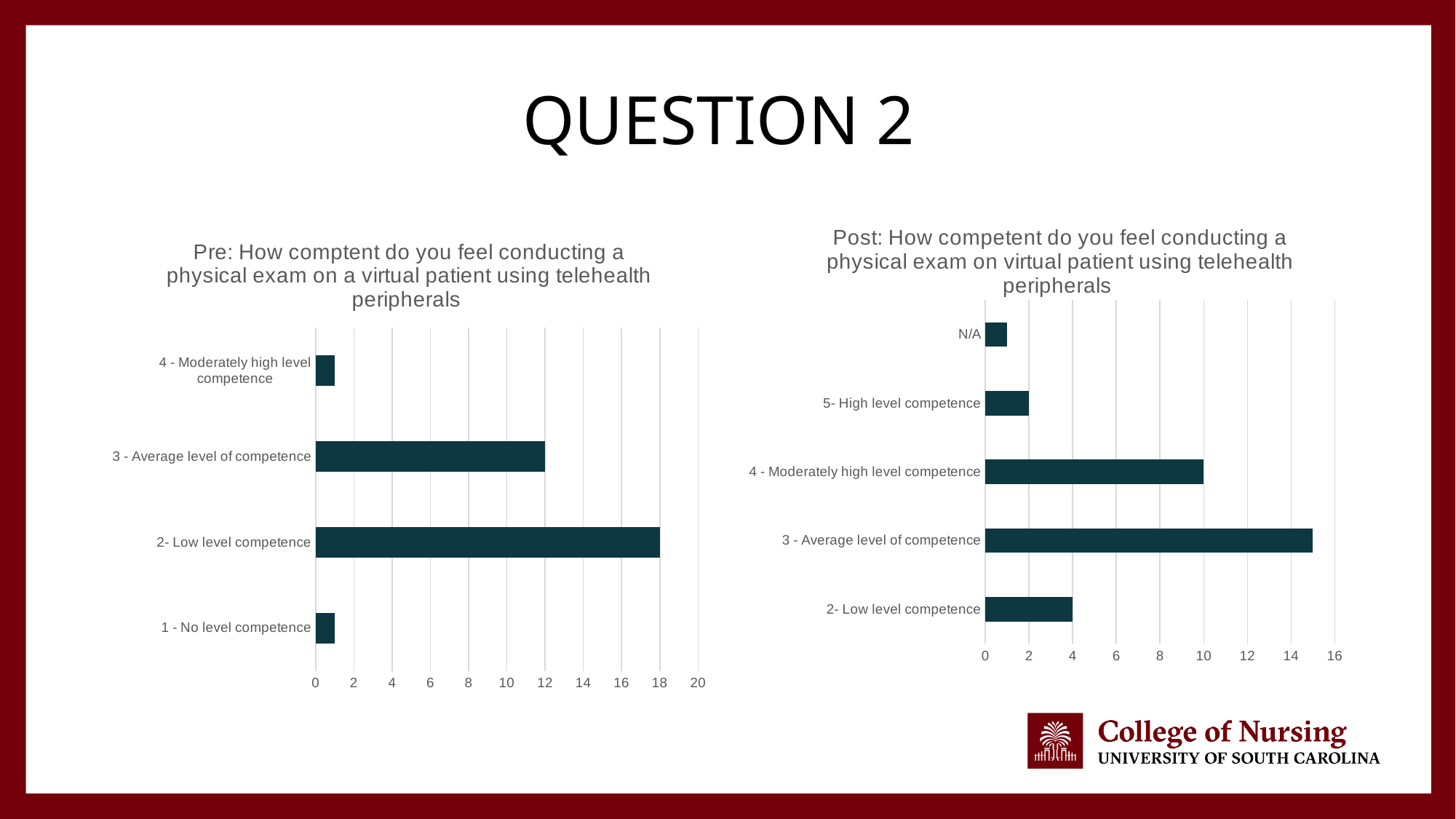
In the Post chart, what is the value for 2- Low level competence? 4 In the Pre chart, what is the value for 2- Low level competence? 18 In the Pre chart, what is the difference between the values for 2- Low level competence and 3 - Average level of competence? 6 In the Pre chart, what is the value for 3 - Average level of competence? 12 In the Post chart, which category has the highest value? 3 - Average level of competence In the Pre chart, which category has the highest value? 2- Low level competence In the Post chart, is the value for 3 - Average level of competence greater or less than 14? greater In the Post chart, how many categories are shown? 5 In the Pre chart, is the value for 1 - No level competence greater or less than 2? less In the Post chart, what is the value for 5- High level competence? 2 In the Pre chart, how many categories are shown? 4 In the Post chart, what is the value for 4 - Moderately high level competence? 10